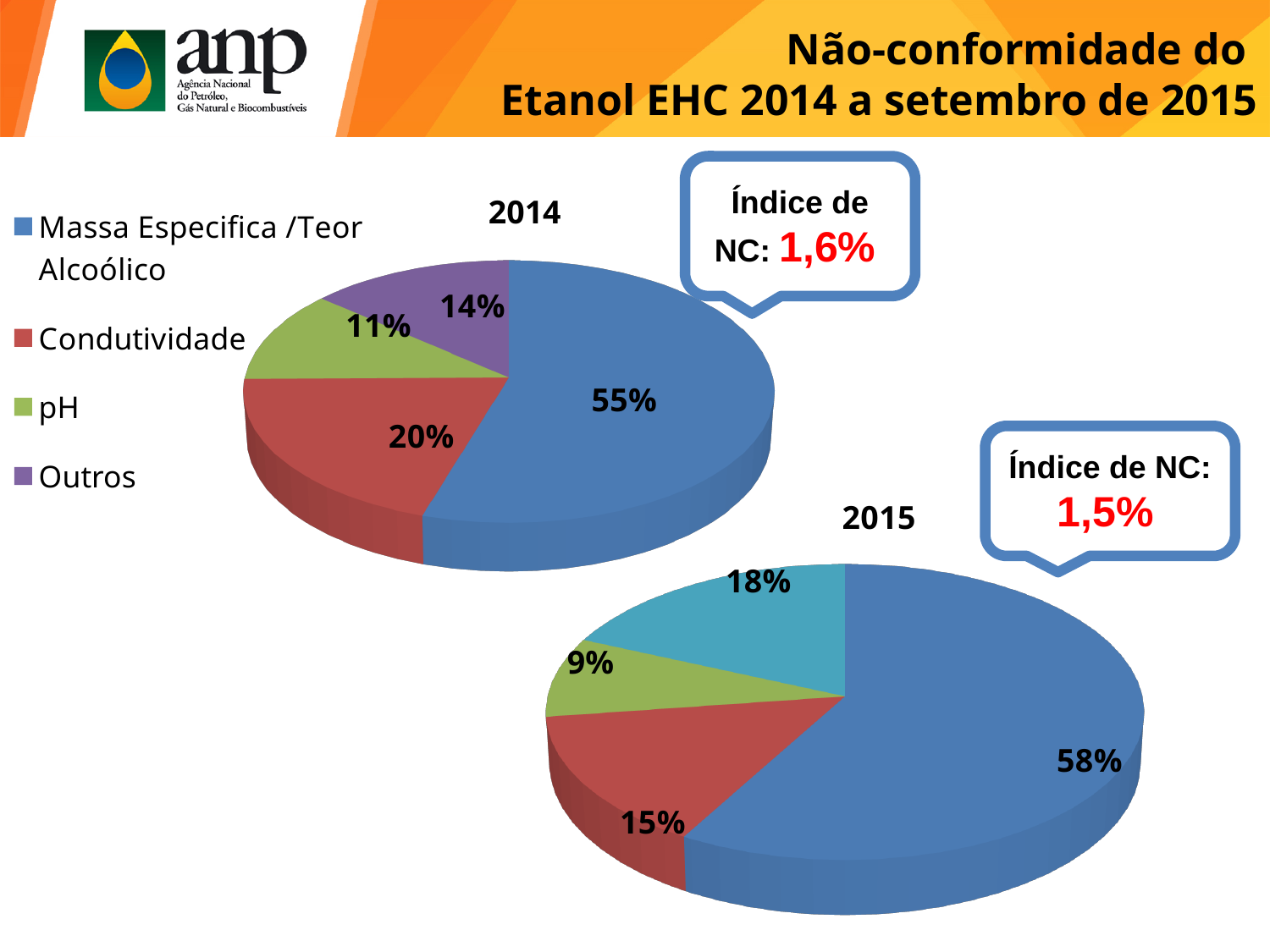
In the 2014 pie chart, what share is shown for pH? 11% What kind of chart is used to show the 2014 data? Pie chart What is the difference between the Condutividade share in 2014 and in 2015? 5% In the 2015 pie chart, what share is shown for Condutividade? 15% In the 2014 pie chart, what share is shown for Condutividade? 20% How many categories does the legend list? 4 In the 2014 pie chart, what share is shown for Massa Especifica /Teor Alcoólico? 55% In the 2015 pie chart, what share is shown for pH? 9% In the 2015 pie chart, what share is shown for Massa Especifica /Teor Alcoólico? 58% In the 2014 pie chart, which category has the smallest share? pH In the 2014 pie chart, what share is shown for Outros? 14% In the 2015 pie chart, which category has the largest share? Massa Especifica /Teor Alcoólico